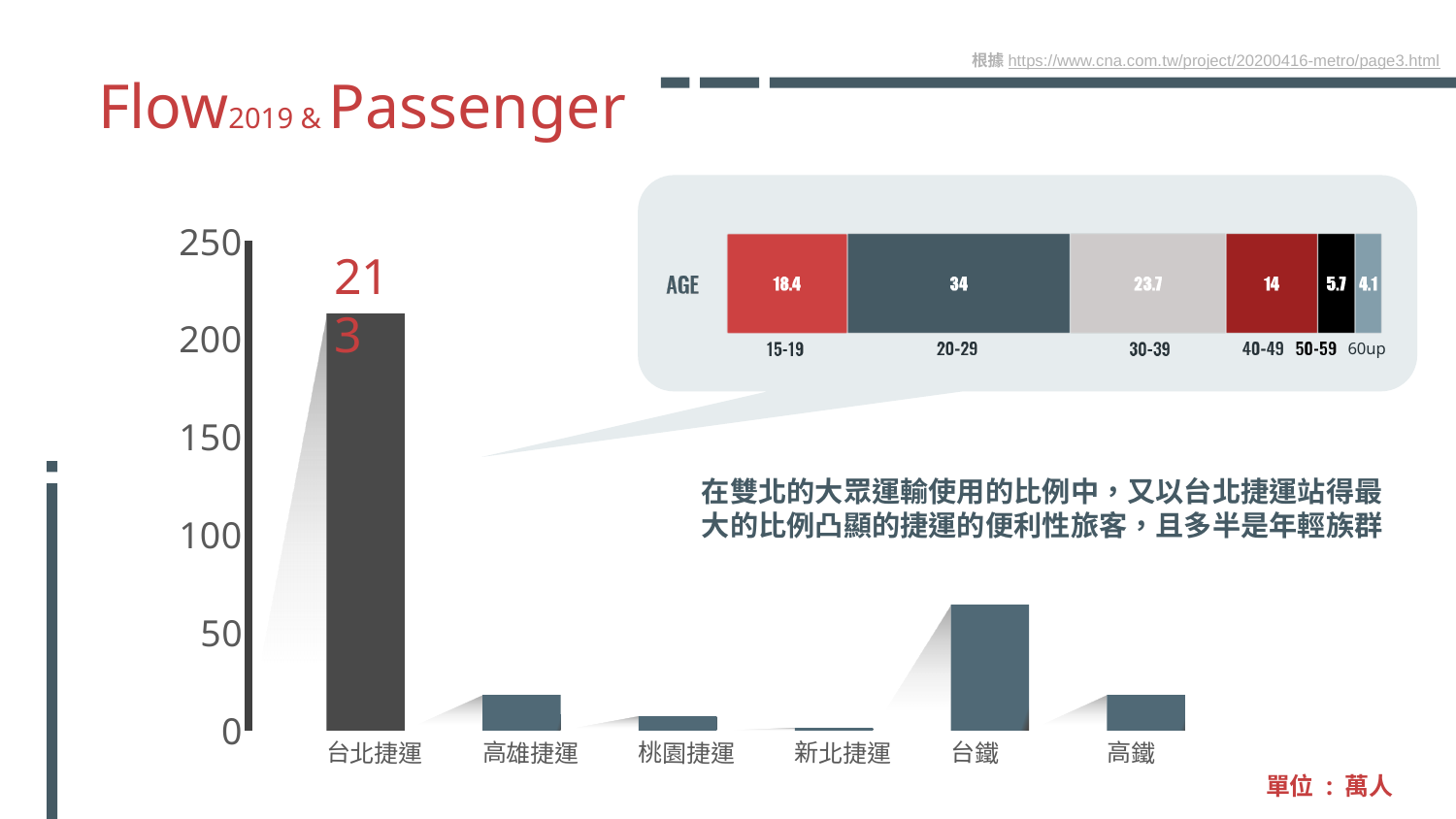
How many categories are shown in the bar chart? 6 In the bar chart, which is larger, 桃園捷運 or 新北捷運? 桃園捷運 What unit is stated for the values in the bar chart? 萬人 In the bar chart, is the value for 台鐵 greater or less than 50? greater What kind of chart is the main chart on the slide? bar chart In the bar chart, what is the value for 台北捷運? 213 In the bar chart, which category has the lowest value? 新北捷運 In the AGE breakdown chart, which age group has the largest value? 20-29 In the bar chart, which is larger, 台鐵 or 高雄捷運? 台鐵 In the AGE breakdown chart, what is the value for the 20-29 group? 34 In the bar chart, which category has the highest value? 台北捷運 In the bar chart, is the value for 高雄捷運 greater or less than 50? less